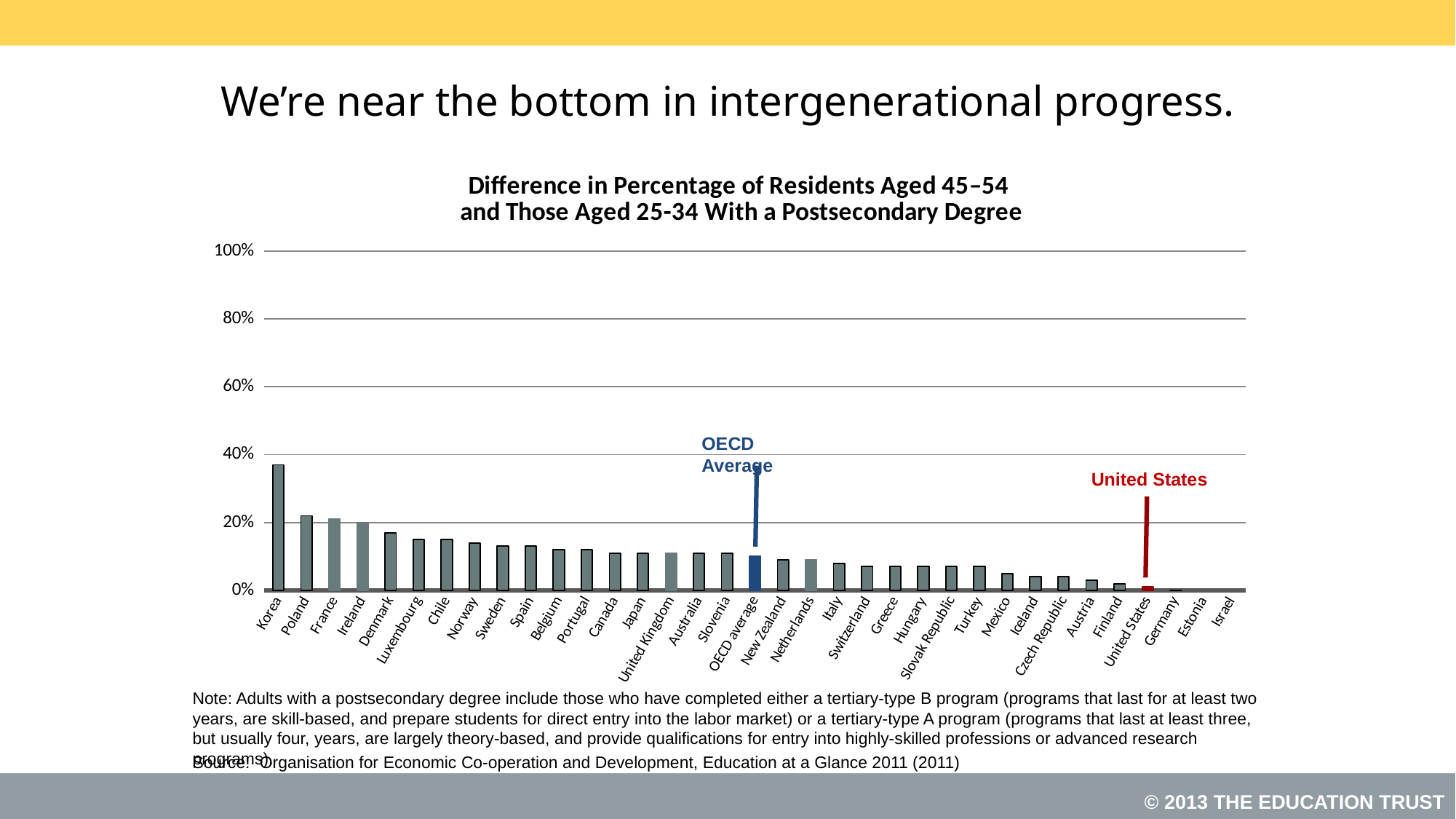
Which country's bar is highlighted in red? United States Do the values rise or fall moving from left to right along the x axis? fall What kind of chart is shown on the slide? bar chart Which is larger, the value for Korea or the value for Poland? Korea How many categories (bars) are shown along the x axis? 35 Is the value for the OECD average greater or less than 20%? less What is the title of the chart? Difference in Percentage of Residents Aged 45–54 and Those Aged 25-34 With a Postsecondary Degree Is the value for Korea greater or less than 20%? greater Is the value for the United States greater or less than 20%? less Which is larger, the value for the United States or the OECD average? OECD average Which country has the highest difference in percentage of residents with a postsecondary degree? Korea